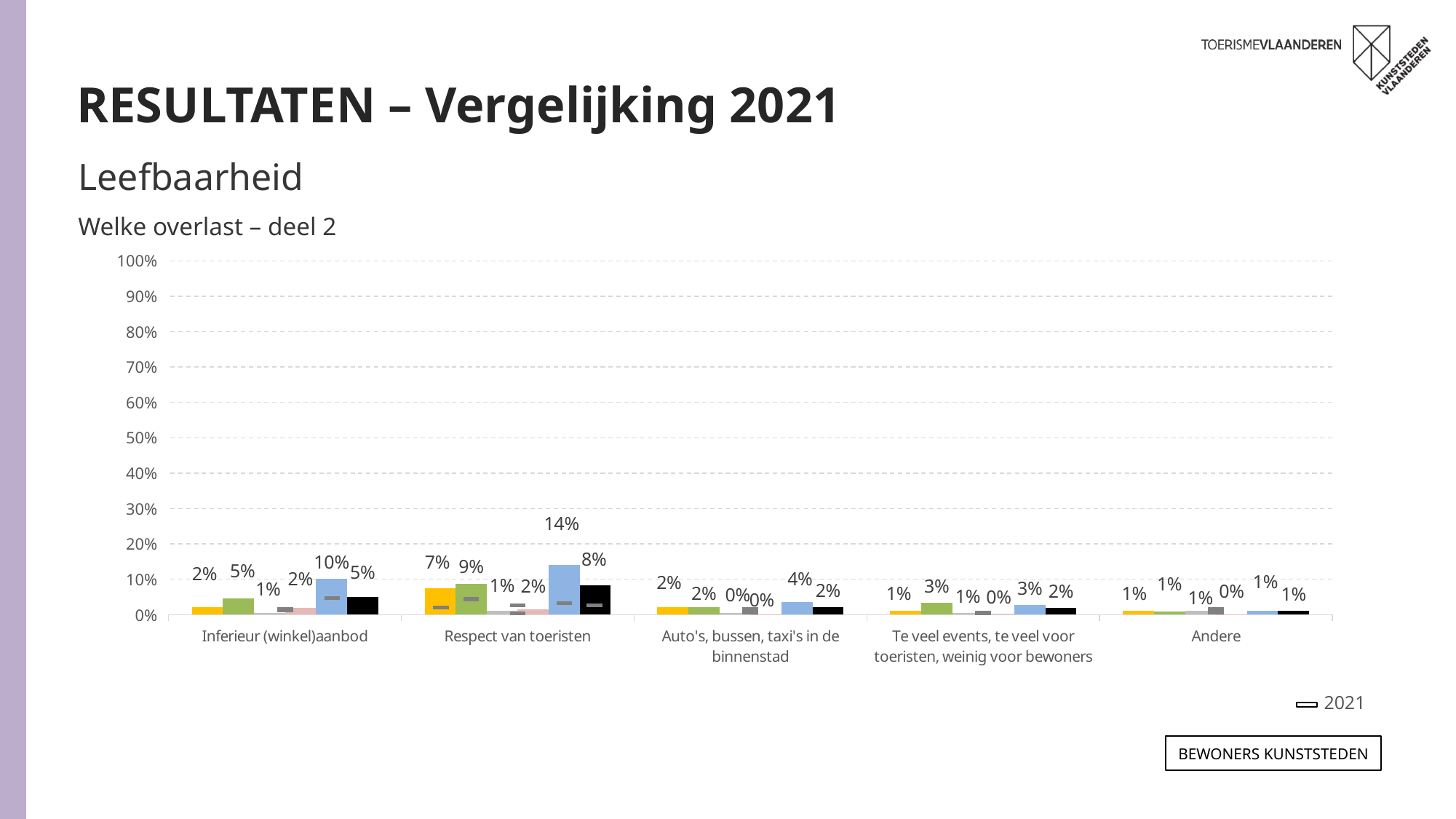
Is the tallest bar in the 'Respect van toeristen' category greater or less than 20%? less What is the highest value shown on the y axis of the chart? 100% What is the difference between the tallest bar in 'Respect van toeristen' (14%) and the tallest bar in 'Inferieur (winkel)aanbod' (10%)? 4 percentage points In which category does the tallest bar on the chart appear? Respect van toeristen What is the value of the first (yellow) bar in the 'Respect van toeristen' category? 7% What is the highest data label shown anywhere on the chart? 14% What entry does the chart legend list? 2021 How many categories are shown along the x axis of the chart? 5 What is the value of the tallest bar in the 'Auto's, bussen, taxi's in de binnenstad' category? 4% What is the value of the tallest bar in the 'Inferieur (winkel)aanbod' category? 10% Which category has the taller maximum bar: 'Respect van toeristen' or 'Te veel events, te veel voor toeristen, weinig voor bewoners'? Respect van toeristen What kind of chart is shown on the slide? bar chart